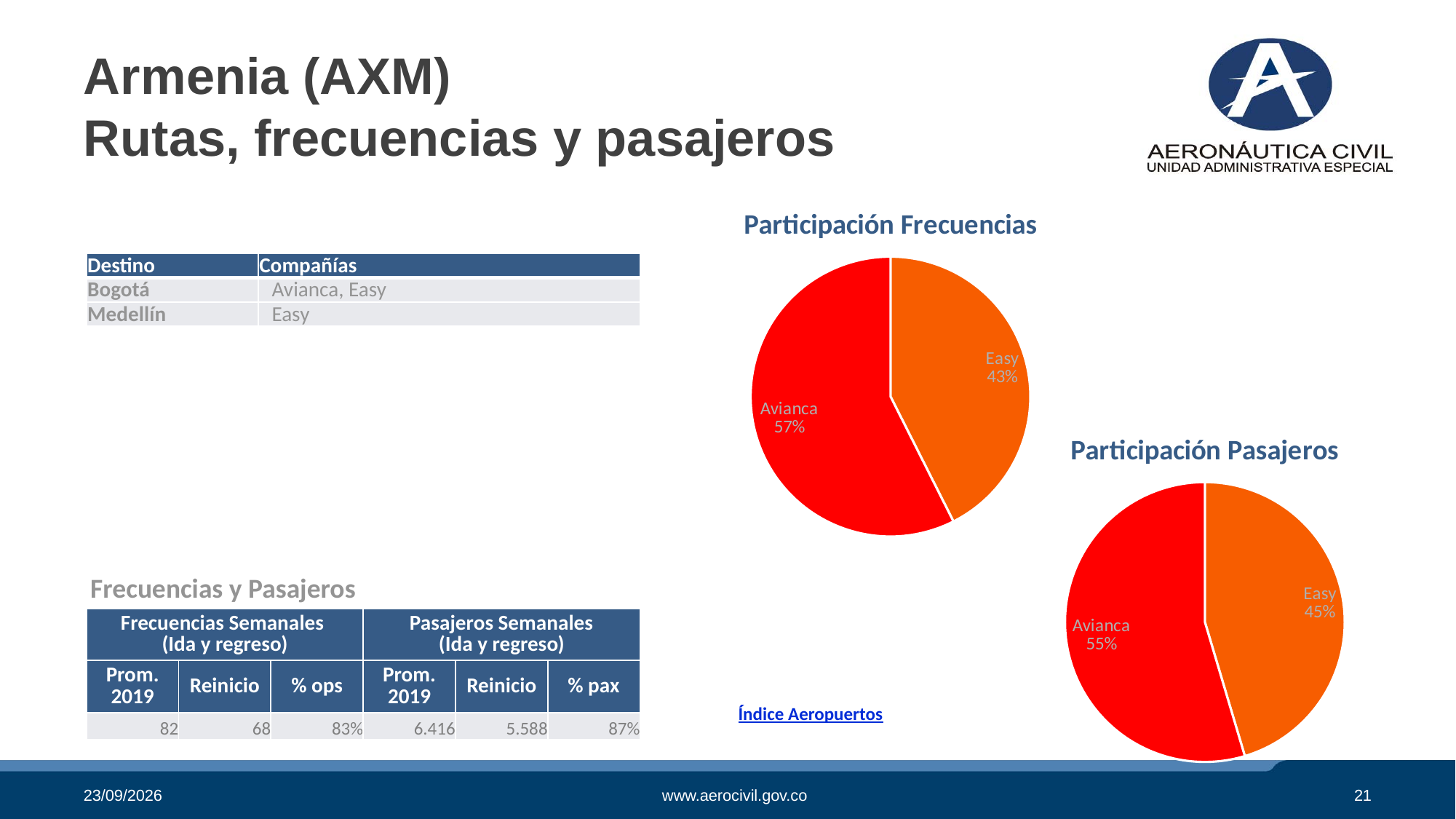
How many slices does the 'Participación Frecuencias' chart have? 2 In the 'Participación Pasajeros' chart, what share does Avianca have? 55% In the 'Participación Frecuencias' chart, what share does Easy have? 43% In the 'Participación Frecuencias' chart, what colour is the Avianca slice? Red In the 'Participación Frecuencias' chart, what share does Avianca have? 57% In the 'Participación Frecuencias' chart, what is the difference in percentage points between Avianca and Easy? 14 In the 'Participación Pasajeros' chart, what share does Easy have? 45% In the 'Participación Pasajeros' chart, which is larger, Avianca's share or Easy's share? Avianca In the 'Participación Frecuencias' chart, which airline has the largest slice? Avianca In the 'Participación Pasajeros' chart, which airline has the smallest slice? Easy What type of chart is 'Participación Pasajeros'? Pie chart In the 'Participación Pasajeros' chart, what is the difference in percentage points between Avianca and Easy? 10